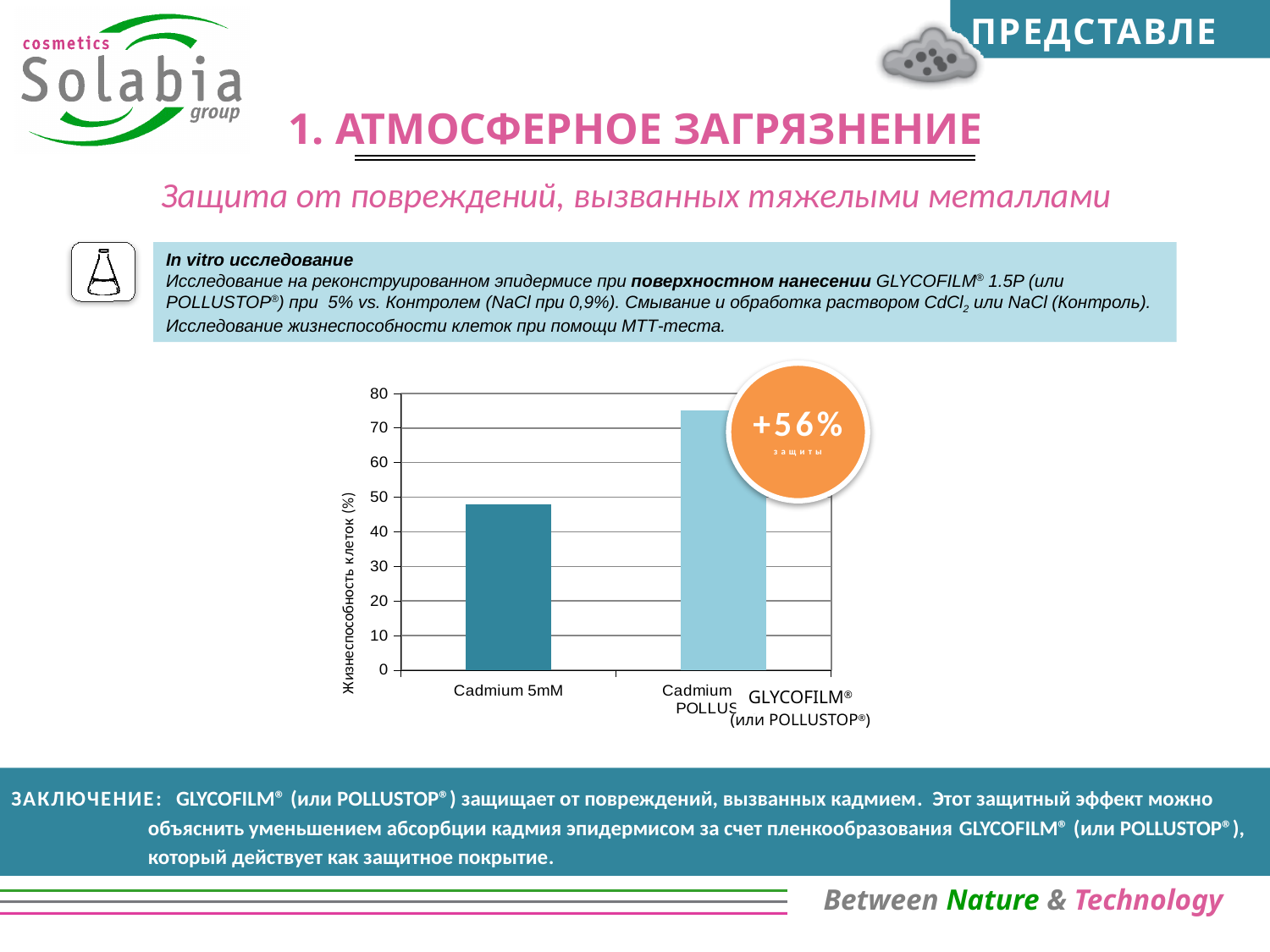
What kind of chart is shown on the slide? bar chart What is the highest tick value shown on the vertical axis? 80 Is the value for Cadmium 5mM greater or less than 60? less Which bar is the lowest in the chart? Cadmium 5mM Which bar is the highest in the chart? Cadmium + GLYCOFILM® (или POLLUSTOP®) Which bar is taller: Cadmium 5mM or Cadmium + GLYCOFILM® (или POLLUSTOP®)? Cadmium + GLYCOFILM® (или POLLUSTOP®) What percentage is shown in the orange circle annotation next to the chart? +56% What is the label of the vertical axis of the chart? Жизнеспособность клеток (%) Is the value for Cadmium 5mM greater or less than 40? greater How many bars are plotted in the chart? 2 Is the value for Cadmium + GLYCOFILM® (или POLLUSTOP®) greater or less than 80? less